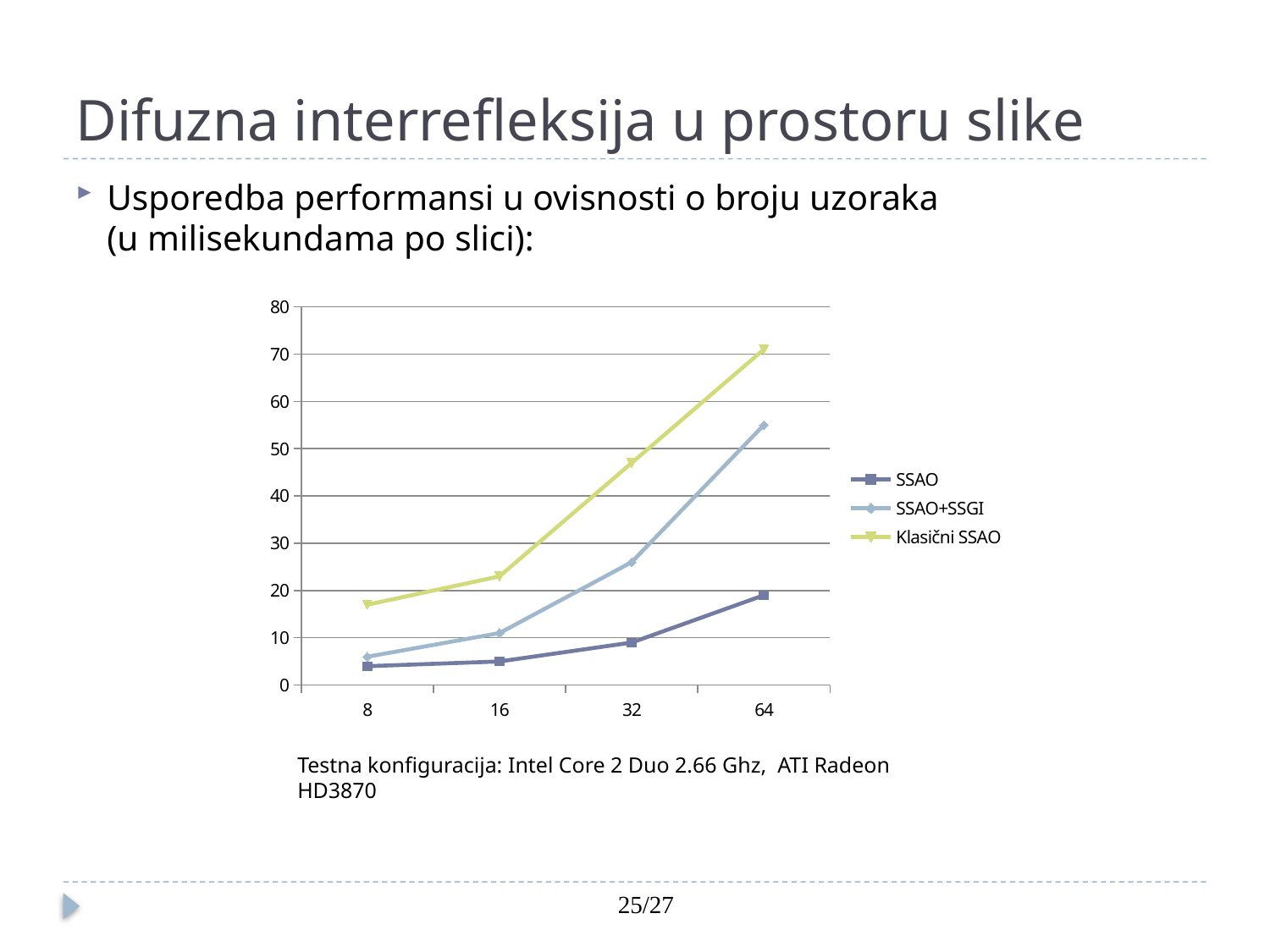
Is the value for SSAO+SSGI at 64 greater or less than 50? greater Which series has the lowest value at 64? SSAO Is the value for Klasični SSAO at 32 greater or less than 40? greater Is the value for SSAO at 64 greater or less than 30? less Which is larger at 16: the value for SSAO+SSGI or the value for Klasični SSAO? Klasični SSAO Which series has the highest value at 64? Klasični SSAO What kind of chart is shown on the slide? line chart How many points are plotted along the x axis for each series? 4 Do the values for SSAO+SSGI rise or fall as the number of samples increases from 8 to 64? rise How many series does the legend list? 3